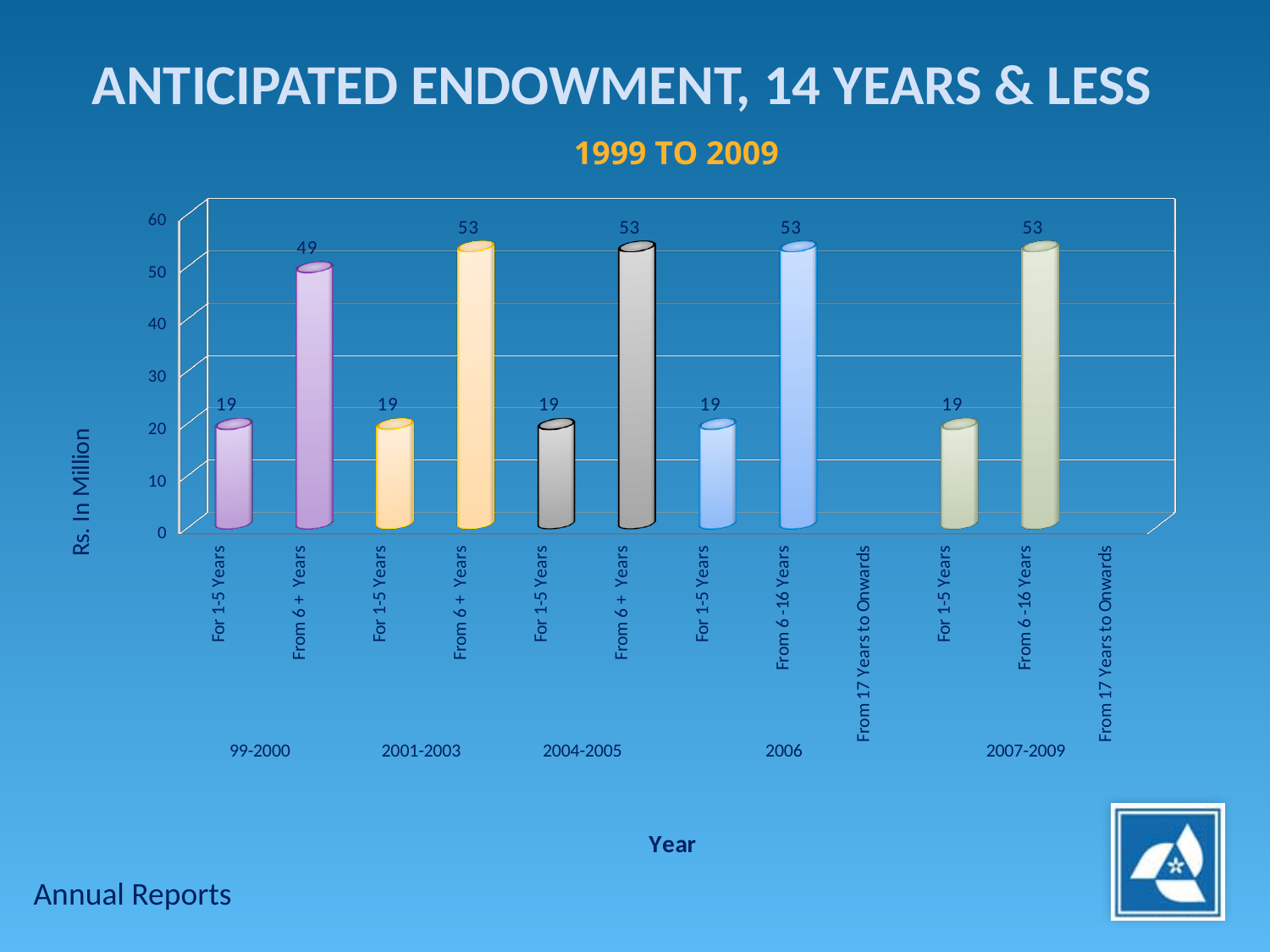
What is the value for 'For 1-5 Years' in the 2004-2005 group? 19 What is the label of the horizontal axis? Year How many bars with data labels are plotted on the chart? 10 What is the difference between 'From 6 -16 Years' and 'For 1-5 Years' in the 2006 group? 34 What is the value for 'From 6 + Years' in the 2001-2003 group? 53 What is the difference between 'From 6 + Years' and 'For 1-5 Years' in the 99-2000 group? 30 What is the value for 'From 6 -16 Years' in the 2007-2009 group? 53 Which year group has the lowest value for the 'From 6 + Years' / 'From 6 -16 Years' bar? 99-2000 What is the value for 'From 6 + Years' in the 99-2000 group? 49 What type of chart is shown on the slide? Bar chart Which is larger: 'From 6 + Years' in 99-2000 or 'From 6 + Years' in 2001-2003? From 6 + Years in 2001-2003 What is the label of the vertical axis? Rs. In Million